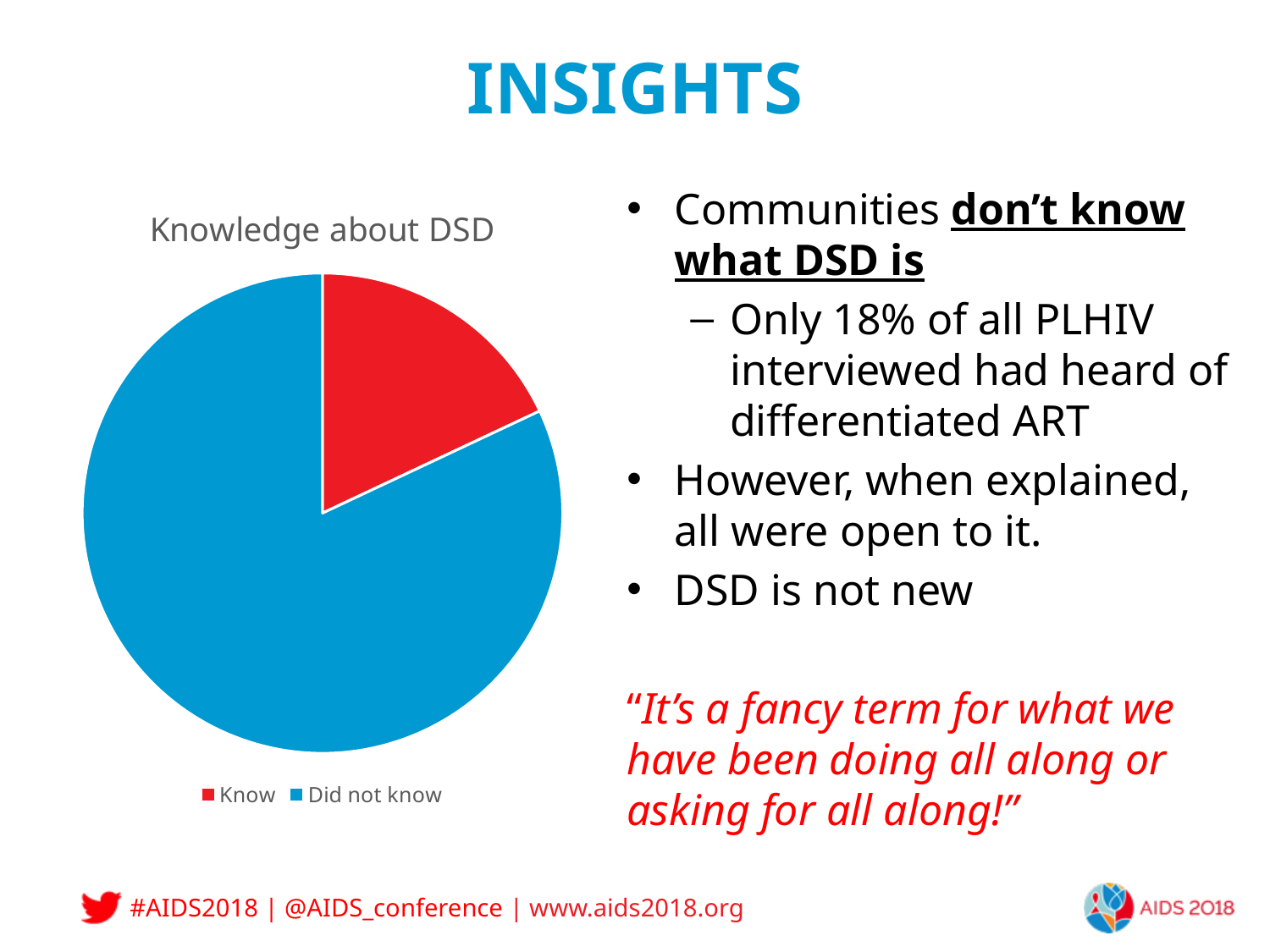
How many entries does the legend of the pie chart list? 2 Which category has the smallest slice in the pie chart? Know What kind of chart is shown on the slide? Pie chart Which category has the largest slice in the pie chart? Did not know What colour is the "Know" slice in the pie chart? Red Which slice is larger, "Know" or "Did not know"? Did not know How many slices does the pie chart have? 2 Does the "Did not know" slice take up more or less than half of the pie? More What is the title of the pie chart? Knowledge about DSD